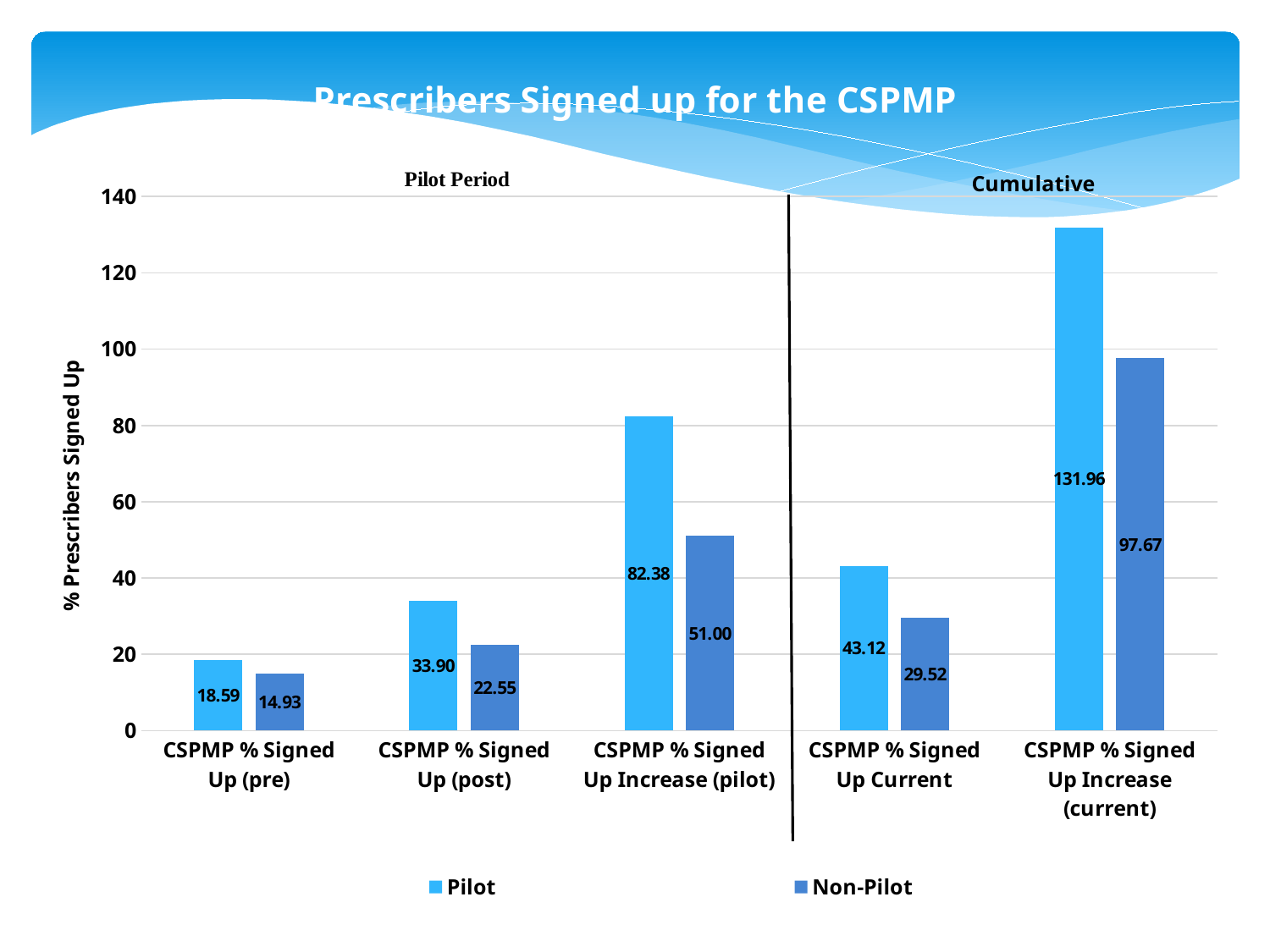
What is the Pilot value for CSPMP % Signed Up (pre)? 18.59 Is the Non-Pilot value for CSPMP % Signed Up Increase (current) greater or less than 100? less Which category has the highest Pilot value? CSPMP % Signed Up Increase (current) What is the difference between the Pilot and Non-Pilot values for CSPMP % Signed Up (post)? 11.35 What kind of chart is shown on the slide? bar chart Which is larger for CSPMP % Signed Up Current, the Pilot value or the Non-Pilot value? Pilot Which category has the lowest Non-Pilot value? CSPMP % Signed Up (pre) What is the Non-Pilot value for CSPMP % Signed Up Increase (pilot)? 51.00 How many categories are shown on the x axis? 5 How many series does the legend list? 2 What is the Non-Pilot value for CSPMP % Signed Up Current? 29.52 What is the Pilot value for CSPMP % Signed Up Increase (current)? 131.96